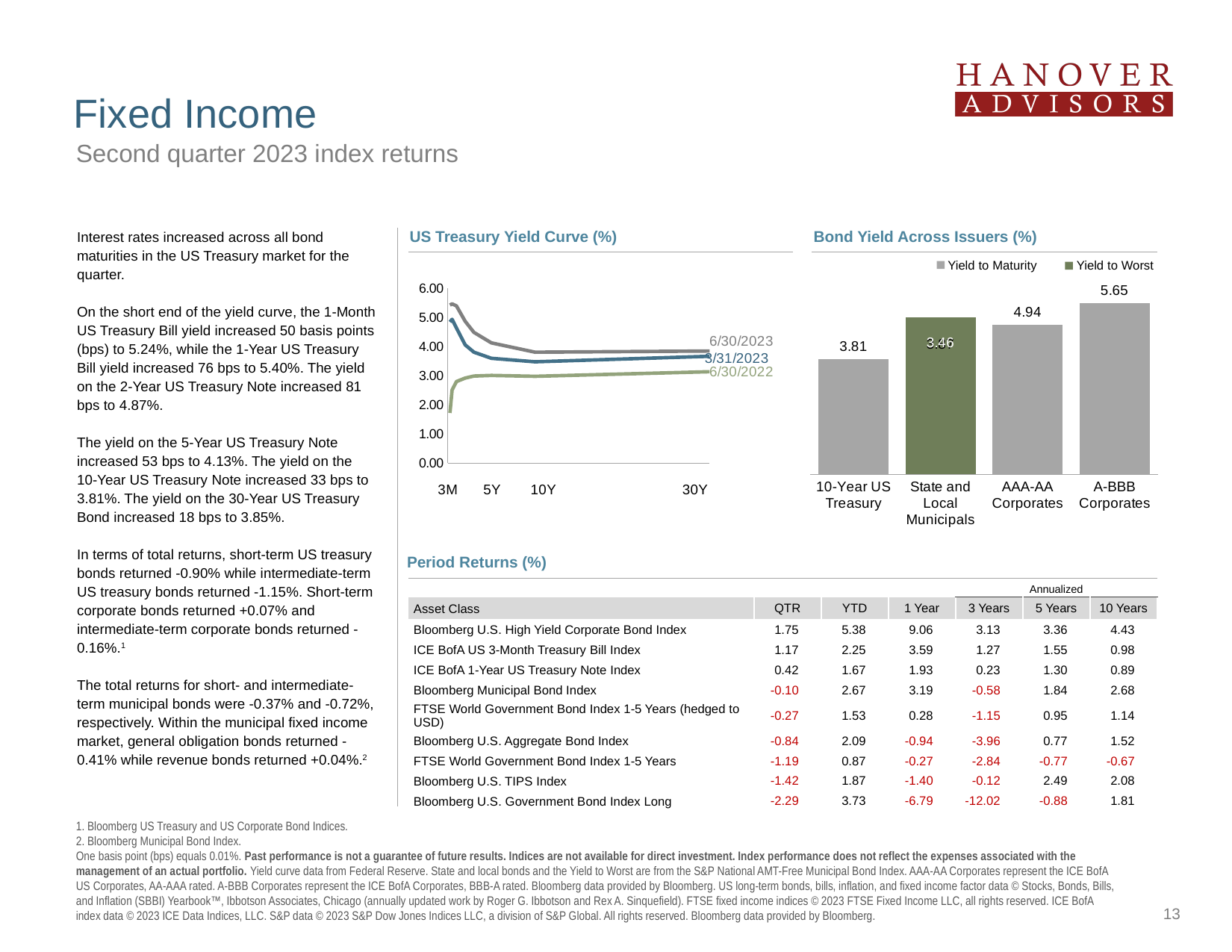
In the Bond Yield Across Issuers chart, what is the yield for AAA-AA Corporates? 4.94 In the US Treasury Yield Curve chart, does the 6/30/2023 line rise or fall from 3M to 30Y? Fall In the Bond Yield Across Issuers chart, which issuer has the highest yield? A-BBB Corporates What kind of chart is the US Treasury Yield Curve chart? Line chart How many issuer categories are shown in the Bond Yield Across Issuers chart? 4 In the Bond Yield Across Issuers chart, what is the difference between the yields of A-BBB Corporates and AAA-AA Corporates? 0.71 In the US Treasury Yield Curve chart, is the 6/30/2022 yield at 3M greater or less than 2.00? less In the US Treasury Yield Curve chart, is the 6/30/2023 yield at 3M greater or less than 5.00? greater How many series does the legend of the Bond Yield Across Issuers chart list? 2 In the Bond Yield Across Issuers chart, what is the yield for the 10-Year US Treasury? 3.81